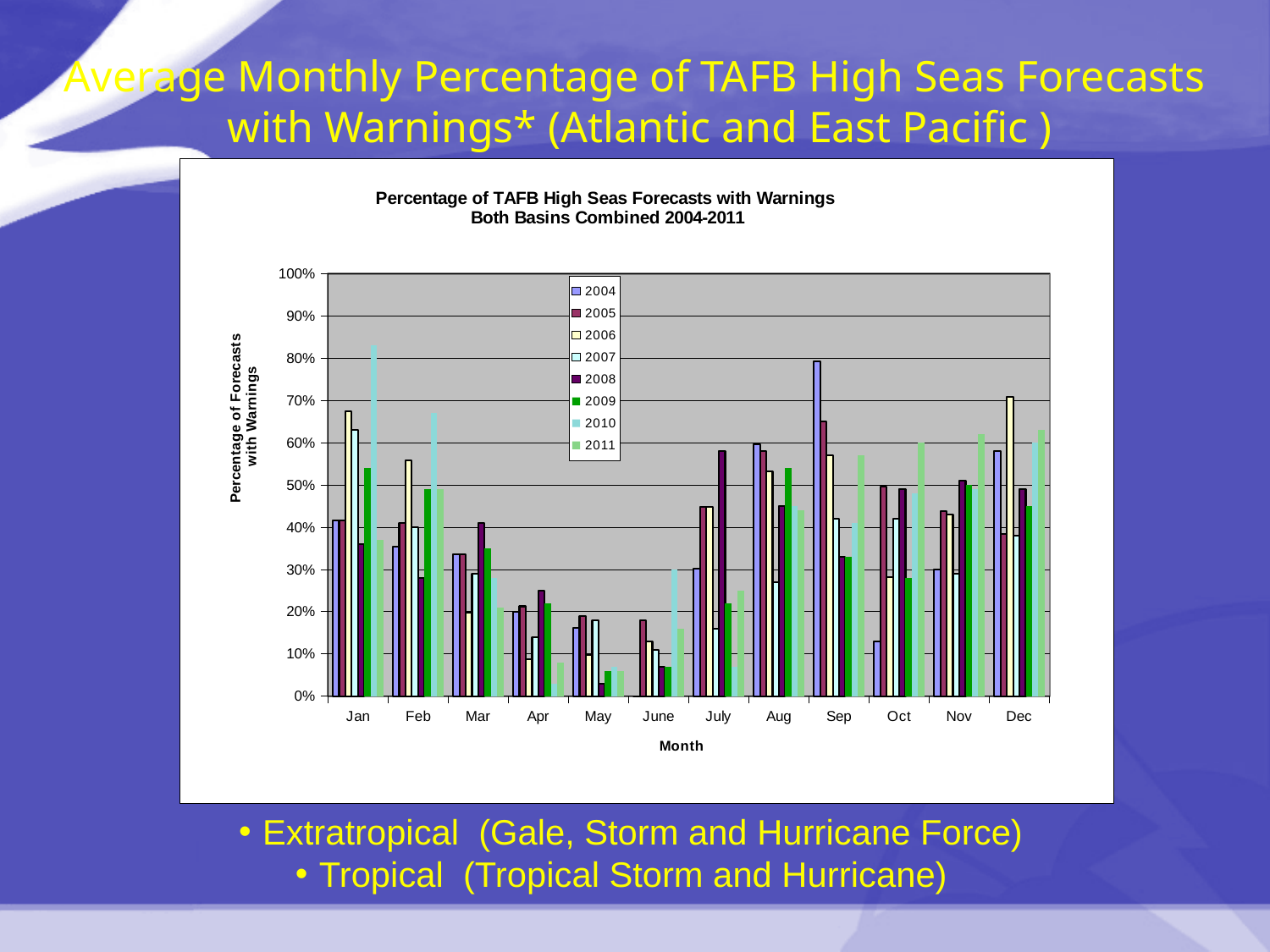
In January, which year has the highest percentage of forecasts with warnings? 2010 Which is larger in September: the value for 2004 or the value for 2005? 2004 What type of chart is shown on the slide? bar chart In September, which year has the highest percentage of forecasts with warnings? 2004 Is the value for July 2008 greater or less than 50%? greater How many series (years) does the legend list? 8 From March to June, do the percentages generally rise or fall? fall Is the value for May 2008 greater or less than 10%? less Is the value for January 2010 greater or less than 70%? greater What is the label on the y axis of the chart? Percentage of Forecasts with Warnings How many months are shown along the x axis? 12 In December, which year has the highest percentage of forecasts with warnings? 2006